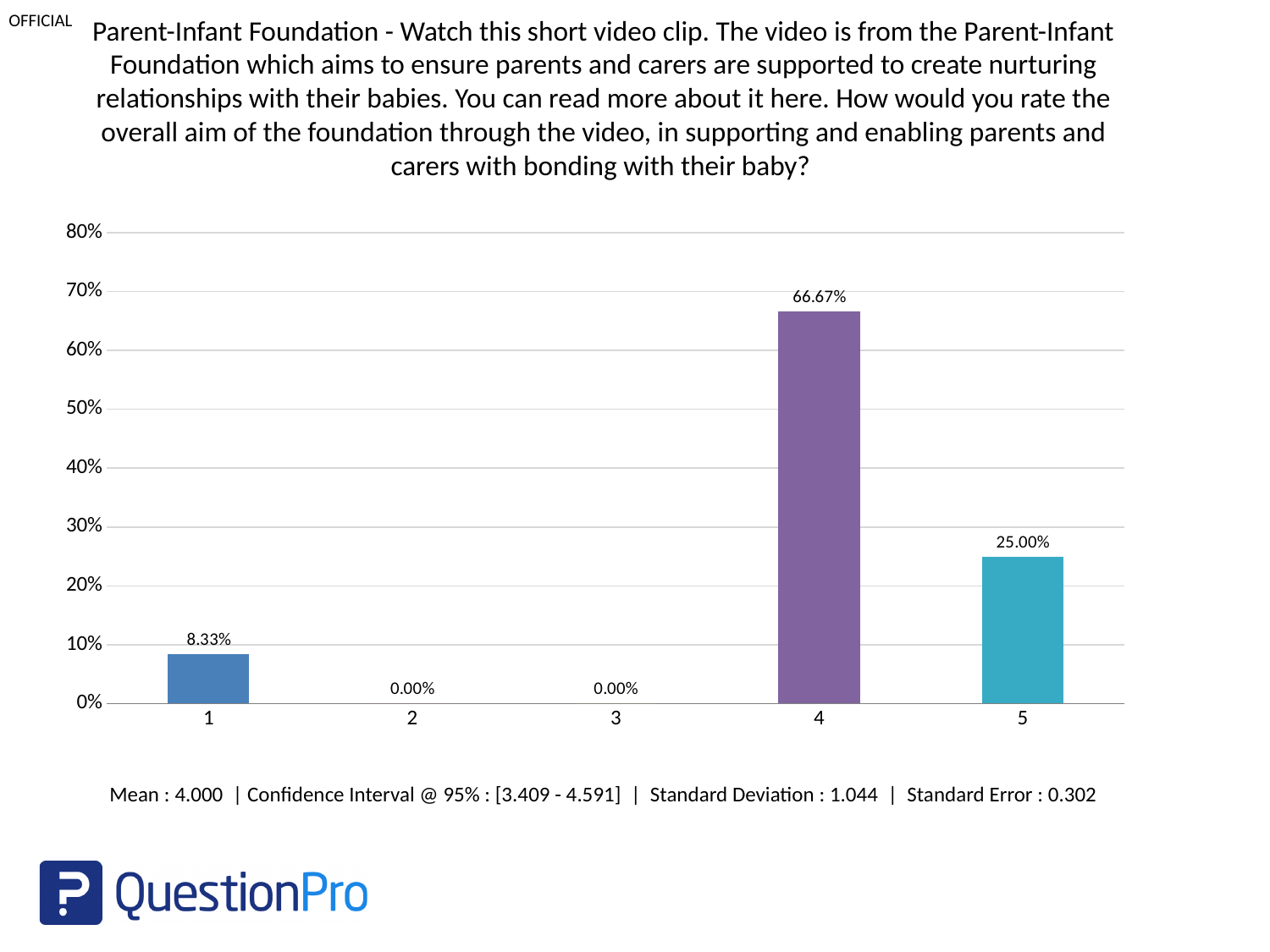
What percentage of respondents gave a rating of 2? 0.00% What percentage of respondents gave a rating of 1? 8.33% What is the mean rating reported below the chart? 4.000 Which rating received the highest percentage of responses? 4 What percentage of respondents gave a rating of 4? 66.67% How many rating categories are shown on the x axis? 5 Which rating has a larger percentage, 1 or 5? 5 What is the difference in percentage between rating 5 and rating 1? 16.67% What is the difference in percentage between rating 4 and rating 5? 41.67% Is the value for rating 4 greater or less than 60%? greater What percentage of respondents gave a rating of 5? 25.00% What kind of chart is shown on the slide? bar chart